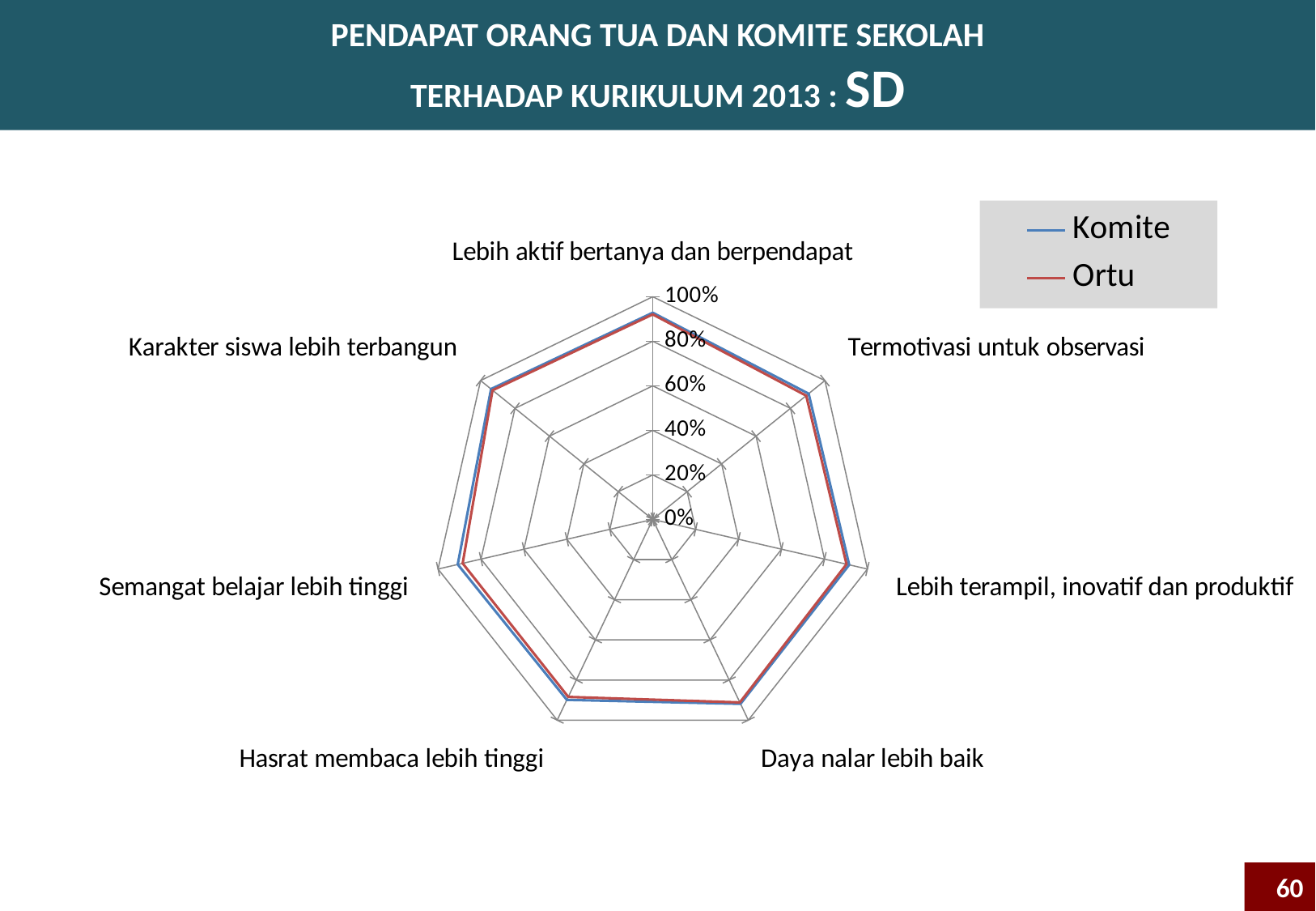
Is the Komite value for 'Hasrat membaca lebih tinggi' greater or less than 80%? greater Is the Ortu value for 'Termotivasi untuk observasi' greater or less than 80%? greater Is the Komite value for 'Lebih terampil, inovatif dan produktif' greater or less than 80%? greater What are the two series named in the legend? Komite and Ortu What is the maximum value shown on the radar chart's axis scale? 100% How many categories (axes) does the radar chart have? 7 What kind of chart is shown on the slide? Radar chart How many series does the legend list? 2